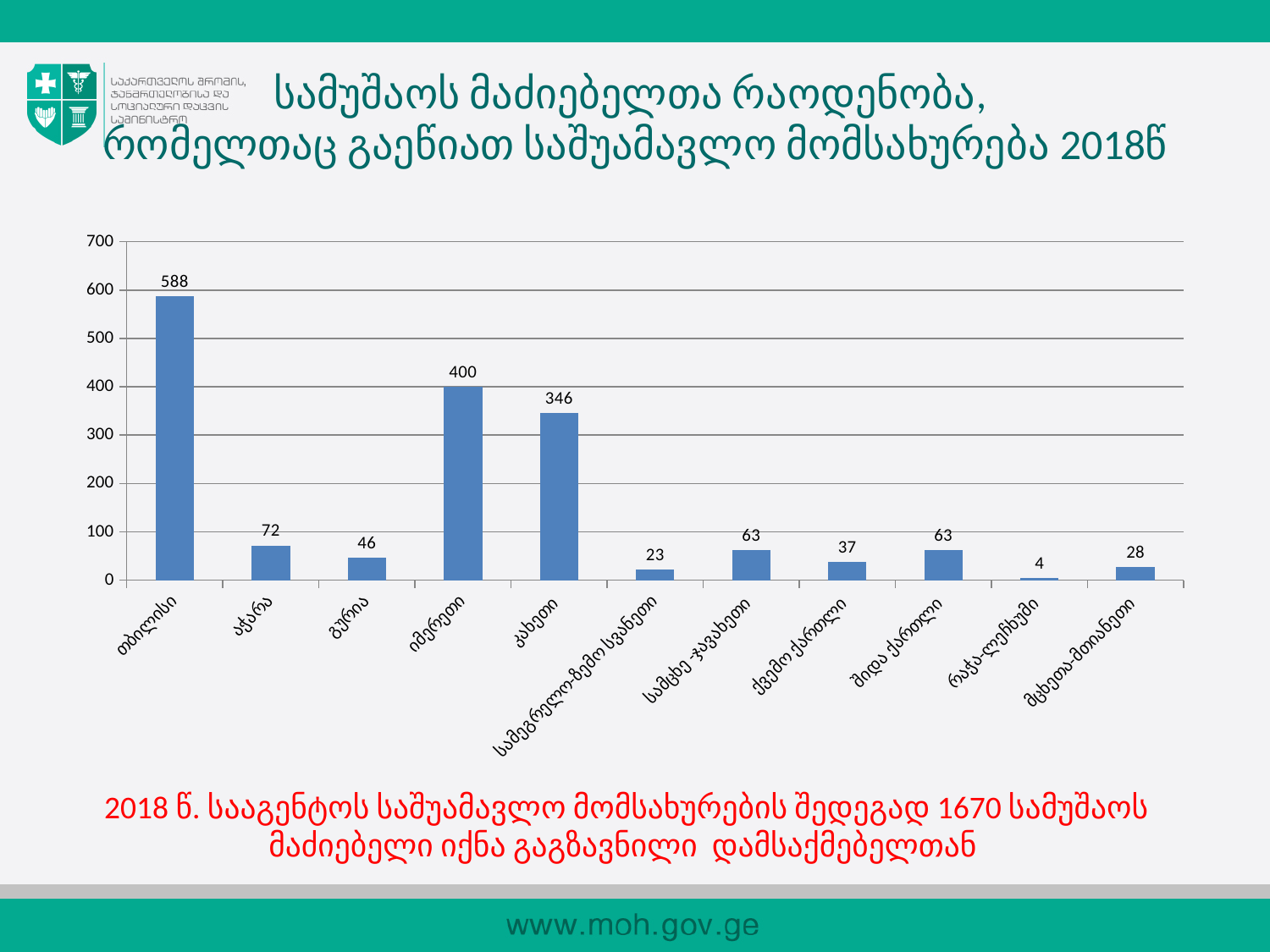
What is the difference between the values for თბილისი and იმერეთი? 188 Which category has the highest value? თბილისი Which category has the lowest value? რაჭა-ლეჩხუმი What kind of chart is shown on the slide? bar chart How many categories are shown on the x axis? 11 What is the difference between the values for სამცხე-ჯავახეთი and ქვემო ქართლი? 26 What is the value for რაჭა-ლეჩხუმი? 4 What is the value for თბილისი? 588 Which is larger, the value for აჭარა or the value for გურია? აჭარა What is the value for კახეთი? 346 What is the value for იმერეთი? 400 Is the value for კახეთი greater or less than 300? greater